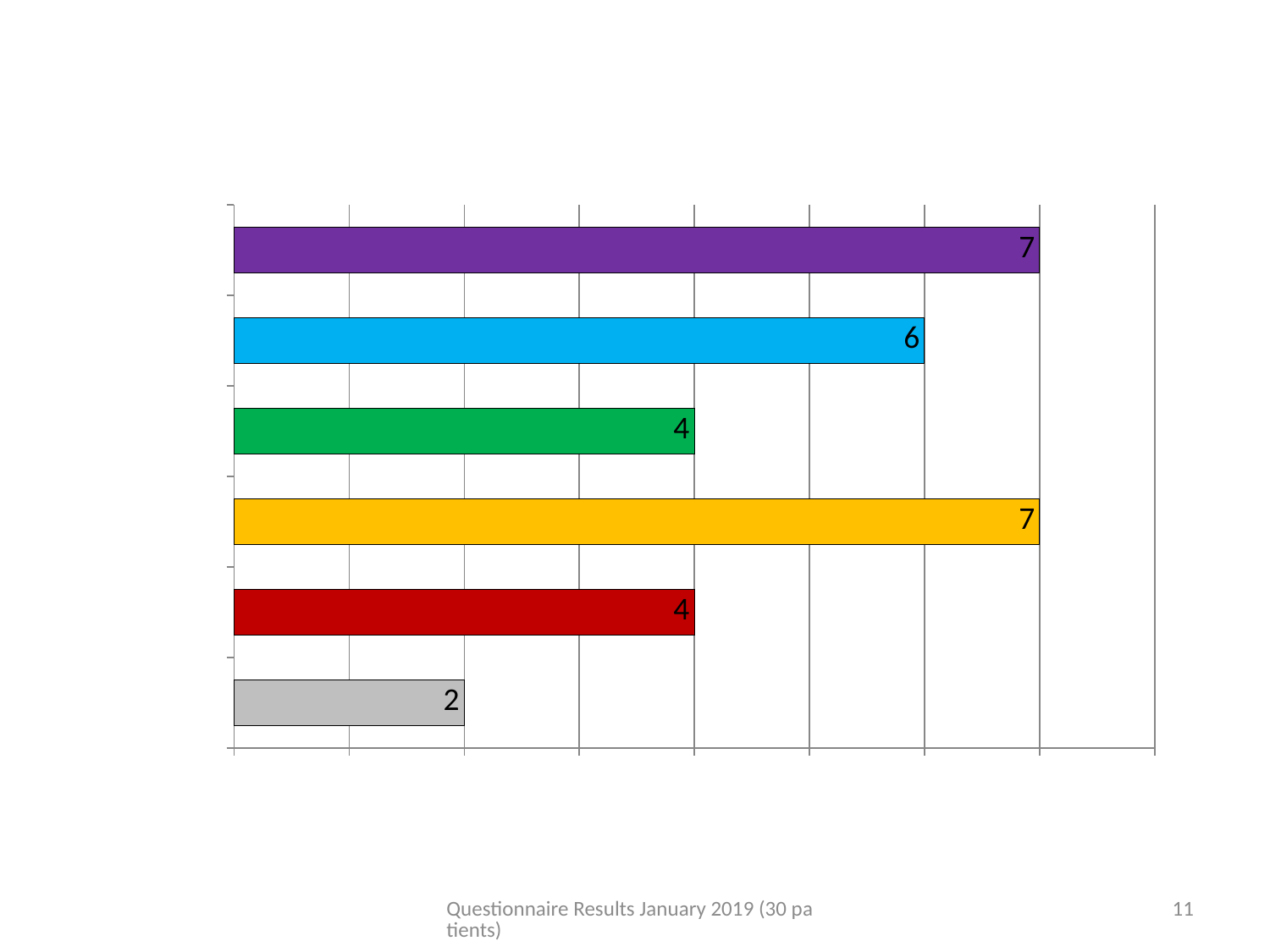
What is the value of the light blue bar? 6 What kind of chart is shown on the slide? bar chart What is the value of the purple bar at the top of the chart? 7 What is the value of the green bar? 4 How many bars are plotted in the chart? 6 Which is larger, the value of the light blue bar or the green bar? the light blue bar What is the value of the red bar? 4 What is the difference between the value of the purple bar and the red bar? 3 What is the value of the yellow bar? 7 What is the value of the grey bar at the bottom of the chart? 2 What is the difference between the value of the light blue bar and the grey bar? 4 Which bar has the lowest value? the grey bar